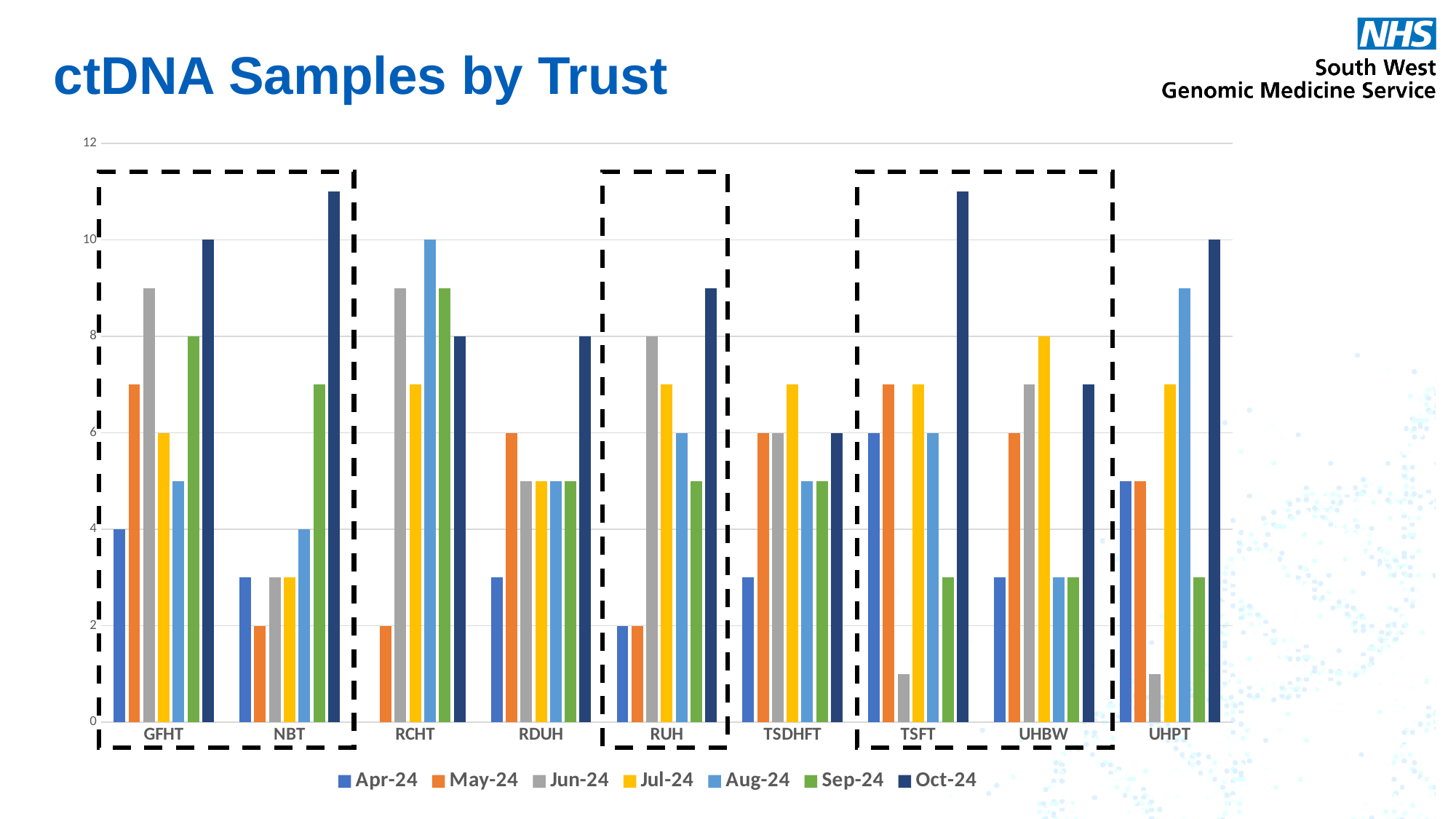
What is the difference between the Oct-24 and Apr-24 values for GFHT? 6 What is the title of the chart? ctDNA Samples by Trust What is the Apr-24 value for GFHT? 4 How many trusts are shown on the x axis of the chart? 9 What is the Aug-24 value for RCHT? 10 Is the Oct-24 value for NBT greater or less than 10? greater What type of chart is shown on the slide? Bar chart Which month has the lowest value for TSFT? Jun-24 Which month has the highest value for UHPT? Oct-24 What is the Oct-24 value for GFHT? 10 How many series does the legend list? 7 What is the Jul-24 value for UHBW? 8